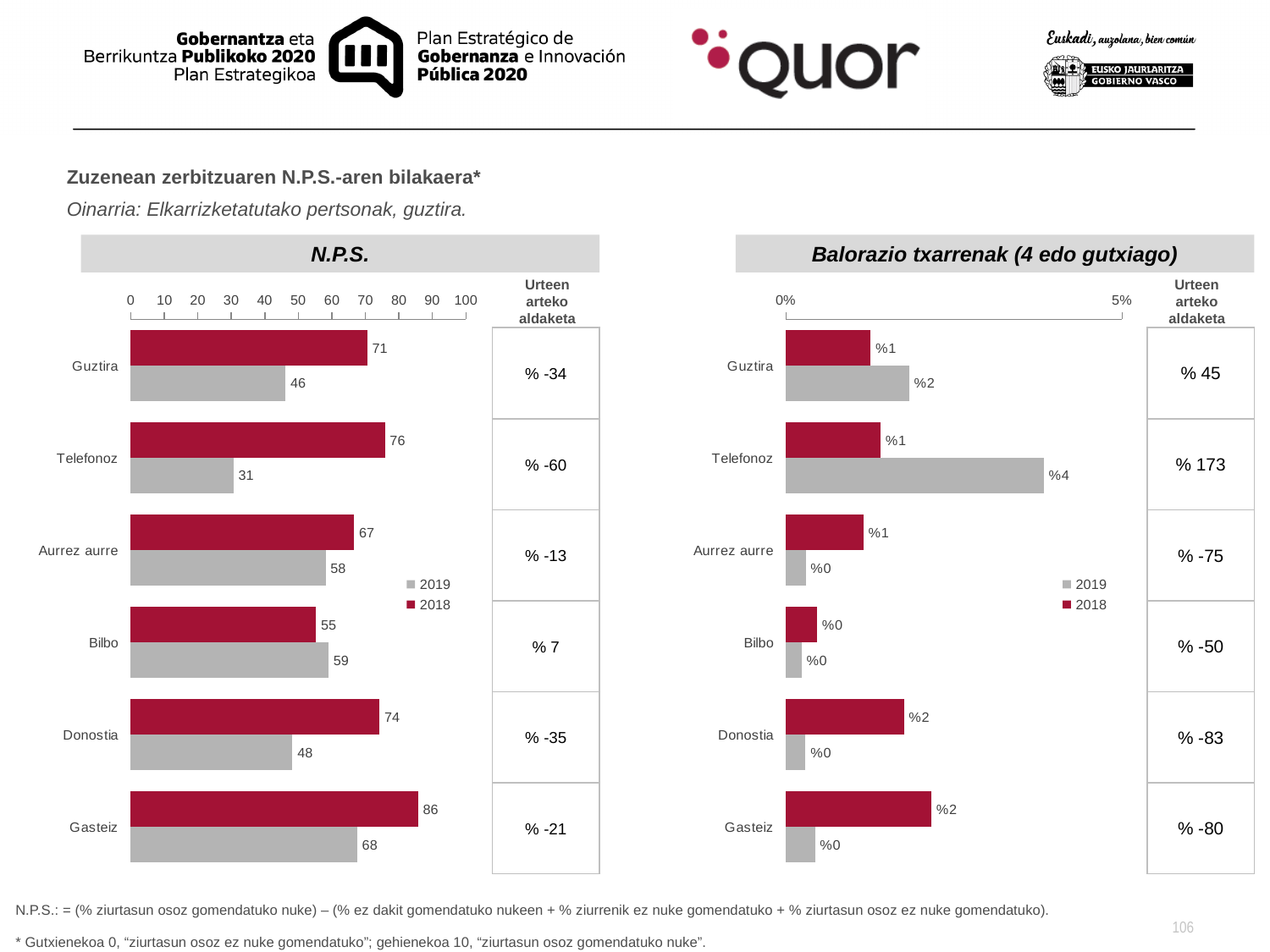
In the N.P.S. chart, what is the 2018 value for Gasteiz? 86 In the N.P.S. chart, how many categories are shown? 6 In the N.P.S. chart, which category has the lowest 2019 value? Telefonoz In the N.P.S. chart, which category has the highest 2018 value? Gasteiz What kind of chart is the Balorazio txarrenak (4 edo gutxiago) chart? Bar chart In the N.P.S. chart, which is larger for Bilbo, the 2018 value or the 2019 value? 2019 In the N.P.S. chart, what is the difference between the 2018 and 2019 values for Guztira? 25 In the N.P.S. chart, what is the 2019 value for Telefonoz? 31 In the Balorazio txarrenak (4 edo gutxiago) chart, which category has the highest 2019 value? Telefonoz In the Balorazio txarrenak (4 edo gutxiago) chart, what is the 2019 value for Telefonoz? %4 In the N.P.S. chart, how many series does the legend list? 2 In the N.P.S. chart, which colour represents the 2018 series? Red